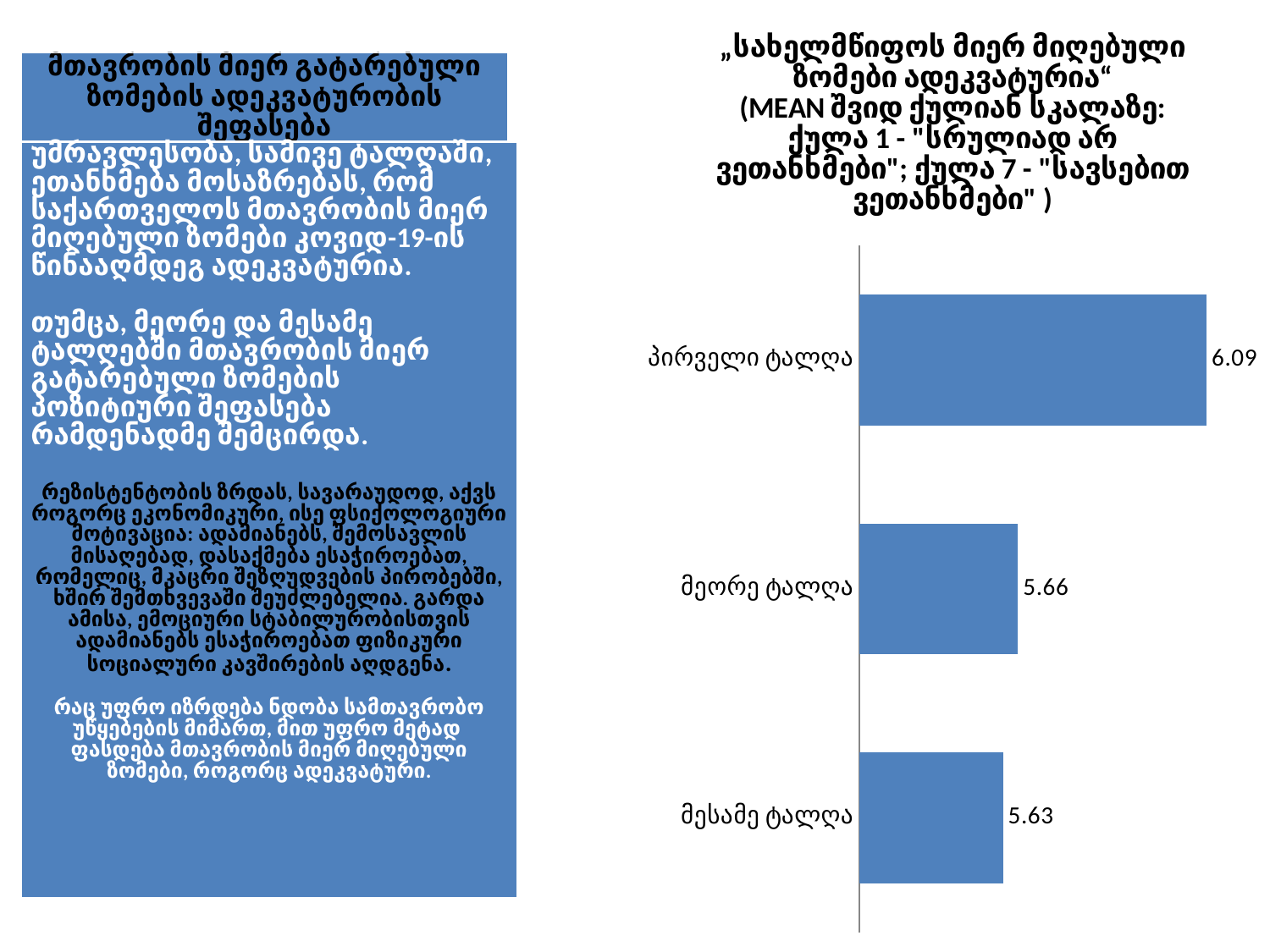
What is the value for მეორე ტალღა? 5.66 What is the value for მესამე ტალღა? 5.63 Which category has the highest value? პირველი ტალღა What is the difference between the values for პირველი ტალღა and მესამე ტალღა? 0.46 What is the value for პირველი ტალღა? 6.09 Which category has the lowest value? მესამე ტალღა Which is larger, the value for მეორე ტალღა or მესამე ტალღა? მეორე ტალღა What is the difference between the values for პირველი ტალღა and მეორე ტალღა? 0.43 What is the difference between the values for მეორე ტალღა and მესამე ტალღა? 0.03 How many categories are shown in the chart? 3 What kind of chart is shown on the slide? Bar chart Do the values rise or fall from პირველი ტალღა to მესამე ტალღა? Fall